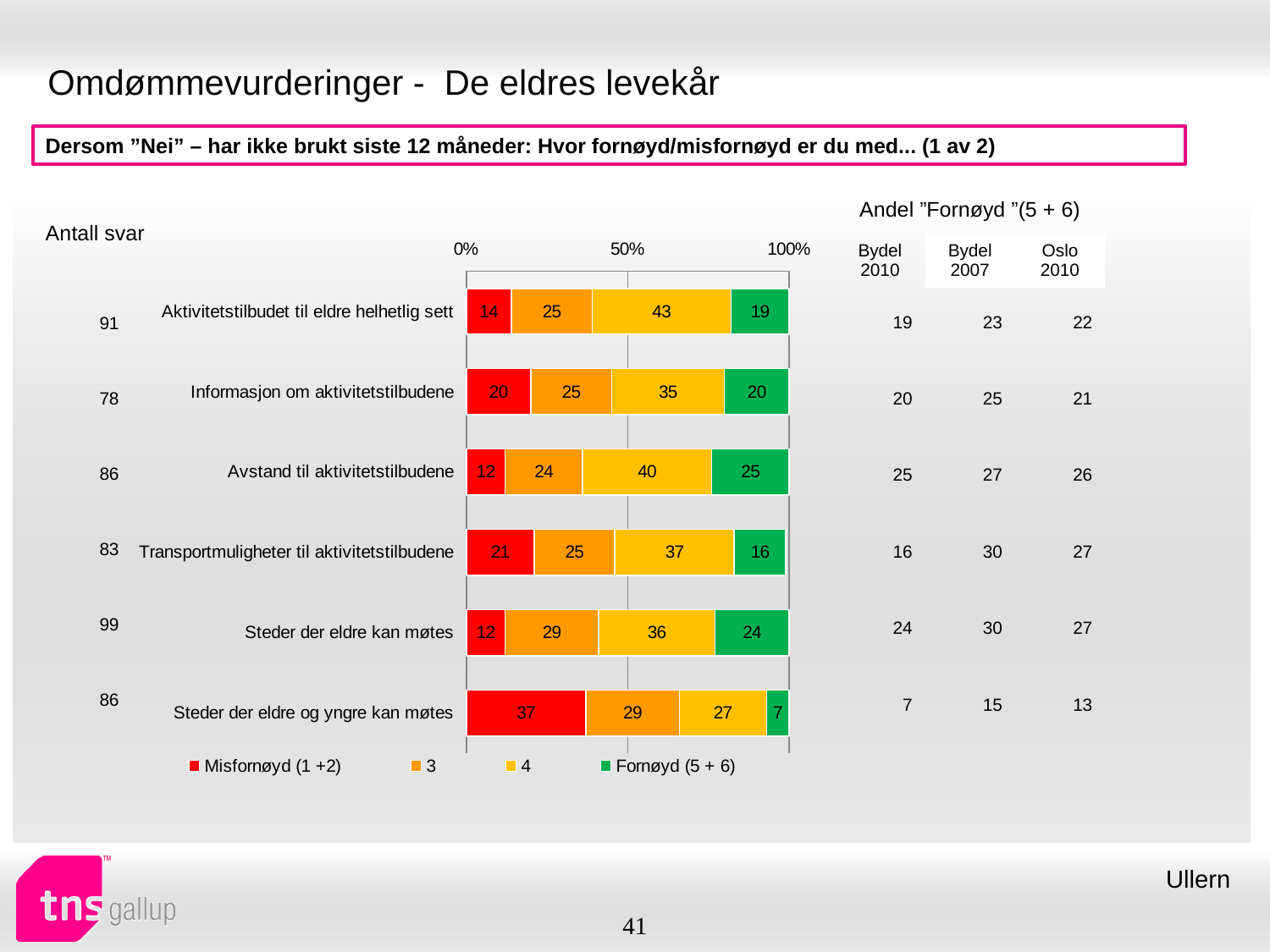
How many series does the legend list? 4 What is the value of the Misfornøyd (1 +2) segment for "Steder der eldre og yngre kan møtes"? 37 What is the total of the stacked bar for "Informasjon om aktivitetstilbudene"? 100 Which is larger: the Fornøyd (5 + 6) value for "Informasjon om aktivitetstilbudene" or for "Transportmuligheter til aktivitetstilbudene"? Informasjon om aktivitetstilbudene Which category has the highest Misfornøyd (1 +2) value? Steder der eldre og yngre kan møtes What is the difference between the Misfornøyd (1 +2) values for "Transportmuligheter til aktivitetstilbudene" and "Avstand til aktivitetstilbudene"? 9 What is the value of the "3" segment for "Steder der eldre kan møtes"? 29 What kind of chart is shown on the slide? Stacked bar chart Which category has the lowest Fornøyd (5 + 6) value? Steder der eldre og yngre kan møtes What is the value of the Fornøyd (5 + 6) segment for "Aktivitetstilbudet til eldre helhetlig sett"? 19 How many categories are shown in the bar chart? 6 What is the value of the "4" segment for "Avstand til aktivitetstilbudene"? 40